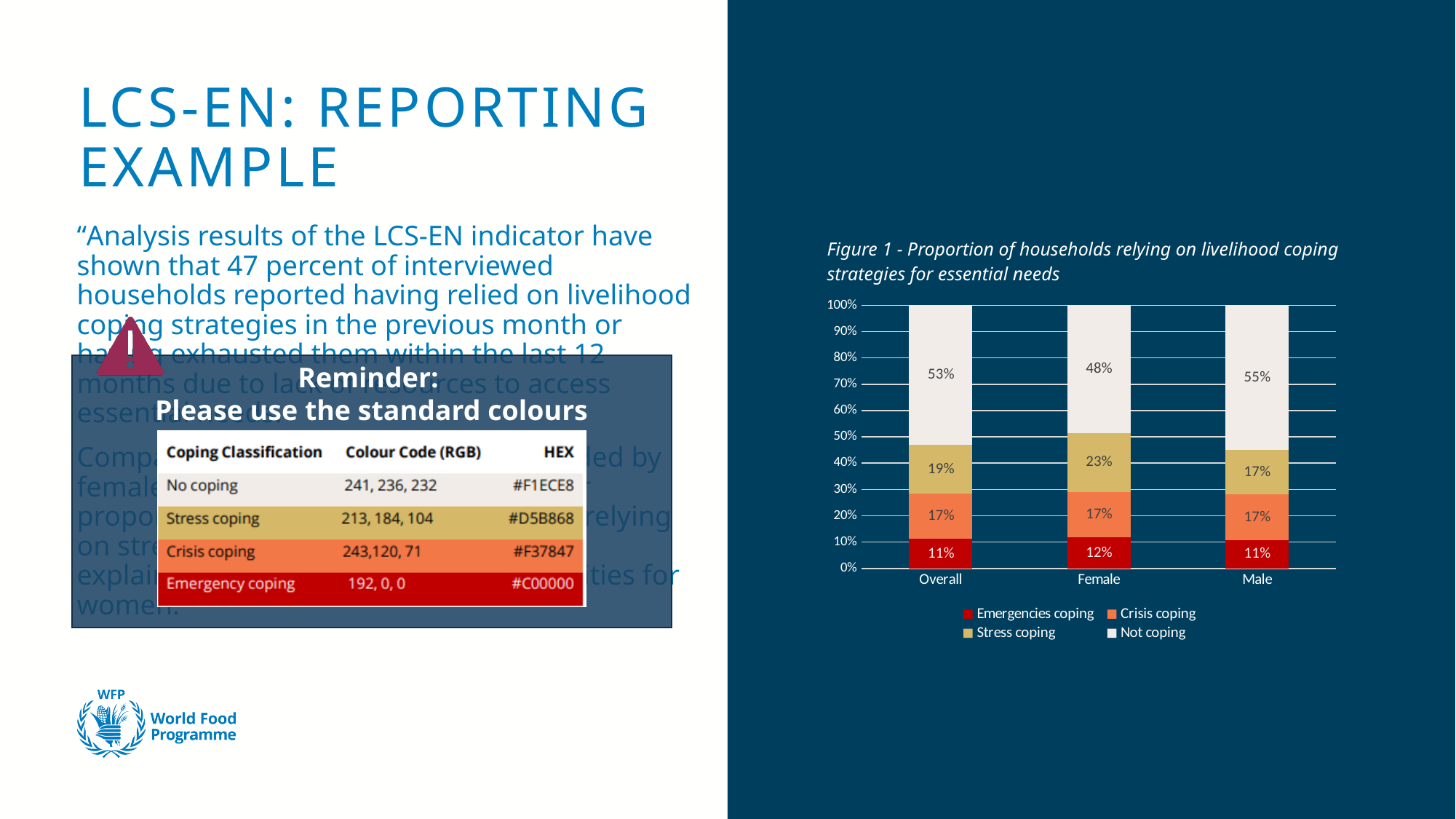
What is the value for Not coping in the Female bar? 48% What is the title of the figure? Figure 1 - Proportion of households relying on livelihood coping strategies for essential needs What is the value for Crisis coping in the Female bar? 17% Which category has the highest value for Not coping? Male What is the difference between the Stress coping values for Female and Male? 6% What is the value for Emergencies coping in the Male bar? 11% Which category has the lowest value for Stress coping? Male How many series does the legend list? 4 What kind of chart is shown? Stacked bar chart Which is larger, the Not coping value for Overall or for Female? Overall How many categories are shown on the x axis? 3 What is the value for Stress coping in the Overall bar? 19%